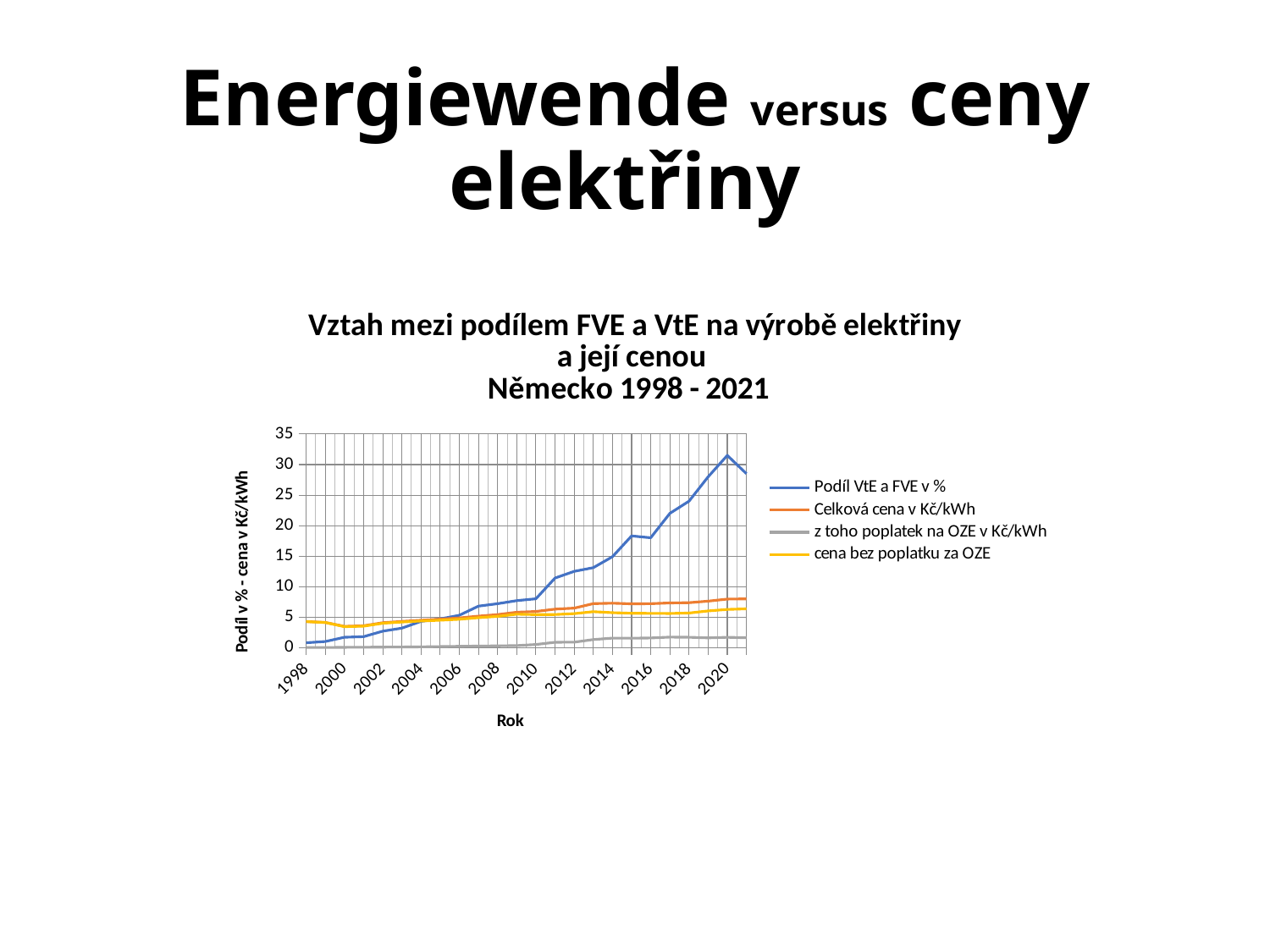
What kind of chart is shown on the slide? line chart Which series reaches the highest value on the chart? Podíl VtE a FVE v % Is the value of z toho poplatek na OZE v Kč/kWh in 2018 greater or less than 5? less What is the label of the x axis? Rok Is the value of Podíl VtE a FVE v % in 2010 greater or less than 10? less In 2020, which is larger: Podíl VtE a FVE v % or Celková cena v Kč/kWh? Podíl VtE a FVE v % How many series does the legend list? 4 What is the title of the chart? Vztah mezi podílem FVE a VtE na výrobě elektřiny a její cenou Německo 1998 - 2021 Does the series Podíl VtE a FVE v % generally rise or fall from 1998 to 2020? rise Is the value of Podíl VtE a FVE v % in 2020 greater or less than 25? greater Which series stays lowest across the whole chart? z toho poplatek na OZE v Kč/kWh How many years does the chart cover, from 1998 to 2021? 24